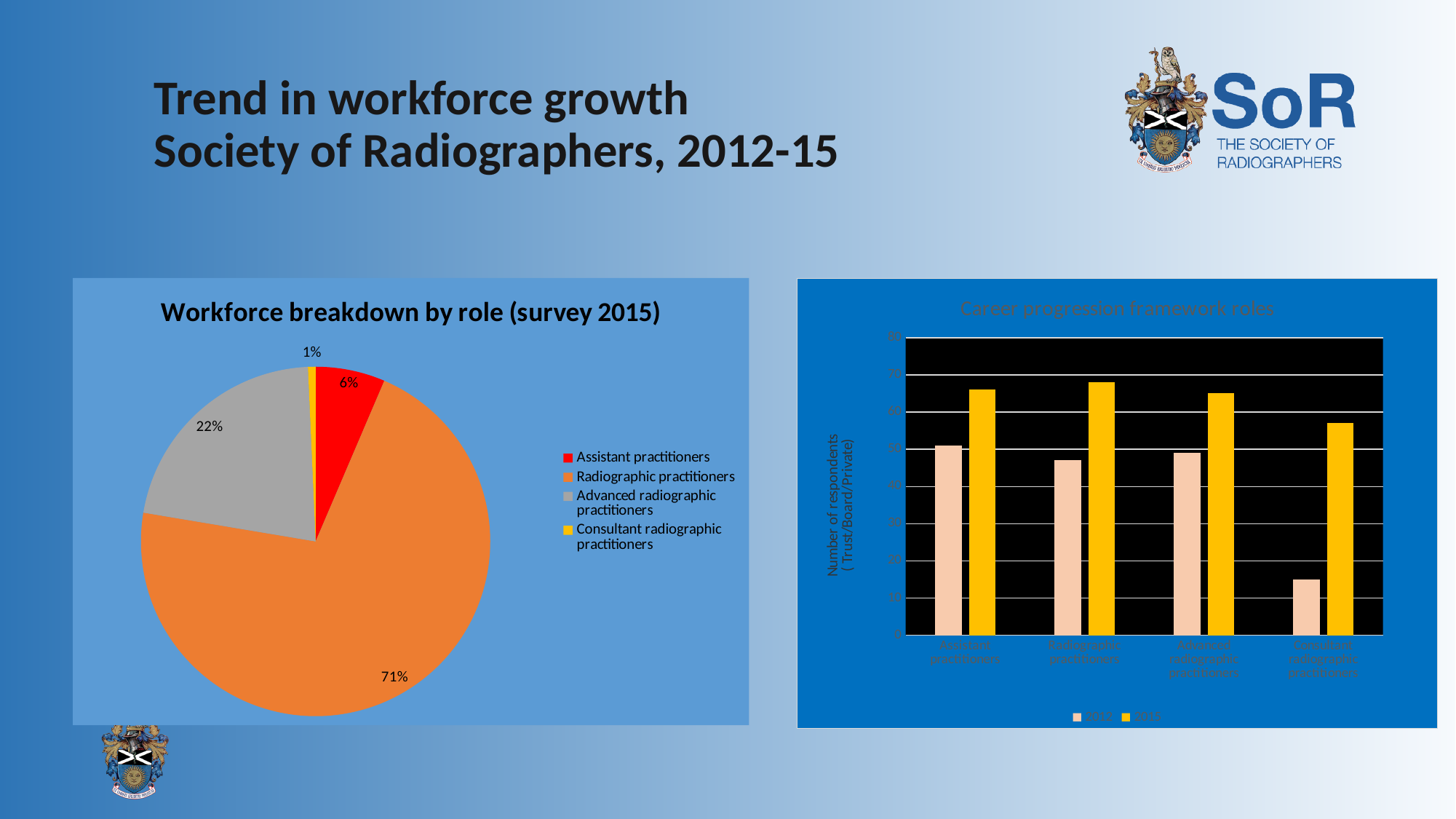
In the 'Workforce breakdown by role (survey 2015)' chart, what percentage is shown for Assistant practitioners? 6% In the 'Workforce breakdown by role (survey 2015)' chart, which role has the smallest slice? Consultant radiographic practitioners In the 'Career progression framework roles' chart, is the 2012 value for Consultant radiographic practitioners greater or less than 20? less What type of chart is the 'Career progression framework roles' chart on the right? Bar chart In the 'Workforce breakdown by role (survey 2015)' chart, what is the difference in percentage points between Advanced radiographic practitioners and Assistant practitioners? 16 What type of chart is the chart on the left of the slide? Pie chart In the 'Workforce breakdown by role (survey 2015)' chart, what percentage is shown for Advanced radiographic practitioners? 22% In the 'Workforce breakdown by role (survey 2015)' chart, what share of the workforce are Radiographic practitioners? 71% How many series does the legend of the 'Career progression framework roles' chart list? 2 In the 'Workforce breakdown by role (survey 2015)' chart, which role has the largest slice? Radiographic practitioners In the 'Career progression framework roles' chart, which is larger for Radiographic practitioners, the 2012 bar or the 2015 bar? 2015 How many slices does the 'Workforce breakdown by role (survey 2015)' pie chart have? 4